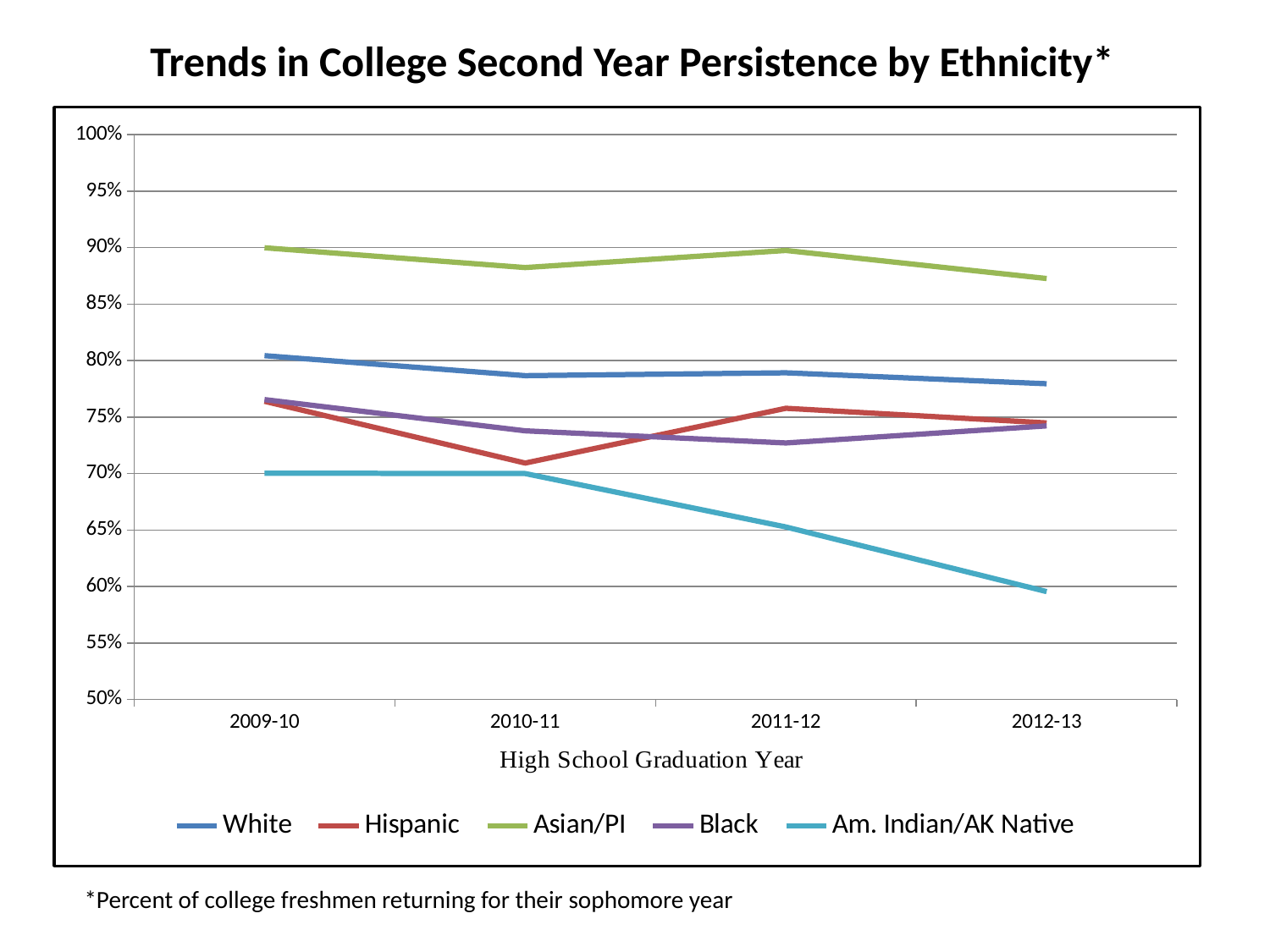
Does the Am. Indian/AK Native line rise or fall from 2010-11 to 2012-13? fall How many high school graduation years are plotted on the x axis? 4 What kind of chart is shown on the slide? line chart In 2011-12, which is higher: Hispanic or Black? Hispanic Is the value for Am. Indian/AK Native in 2012-13 greater or less than 65%? less How many series does the legend list? 5 What is the title of the x axis? High School Graduation Year Which ethnicity has the highest second year persistence in 2012-13? Asian/PI Is the value for Asian/PI in 2010-11 greater or less than 85%? greater In 2010-11, which is higher: Black or Hispanic? Black Is the value for White in 2012-13 greater or less than 80%? less Which ethnicity has the lowest second year persistence in 2012-13? Am. Indian/AK Native